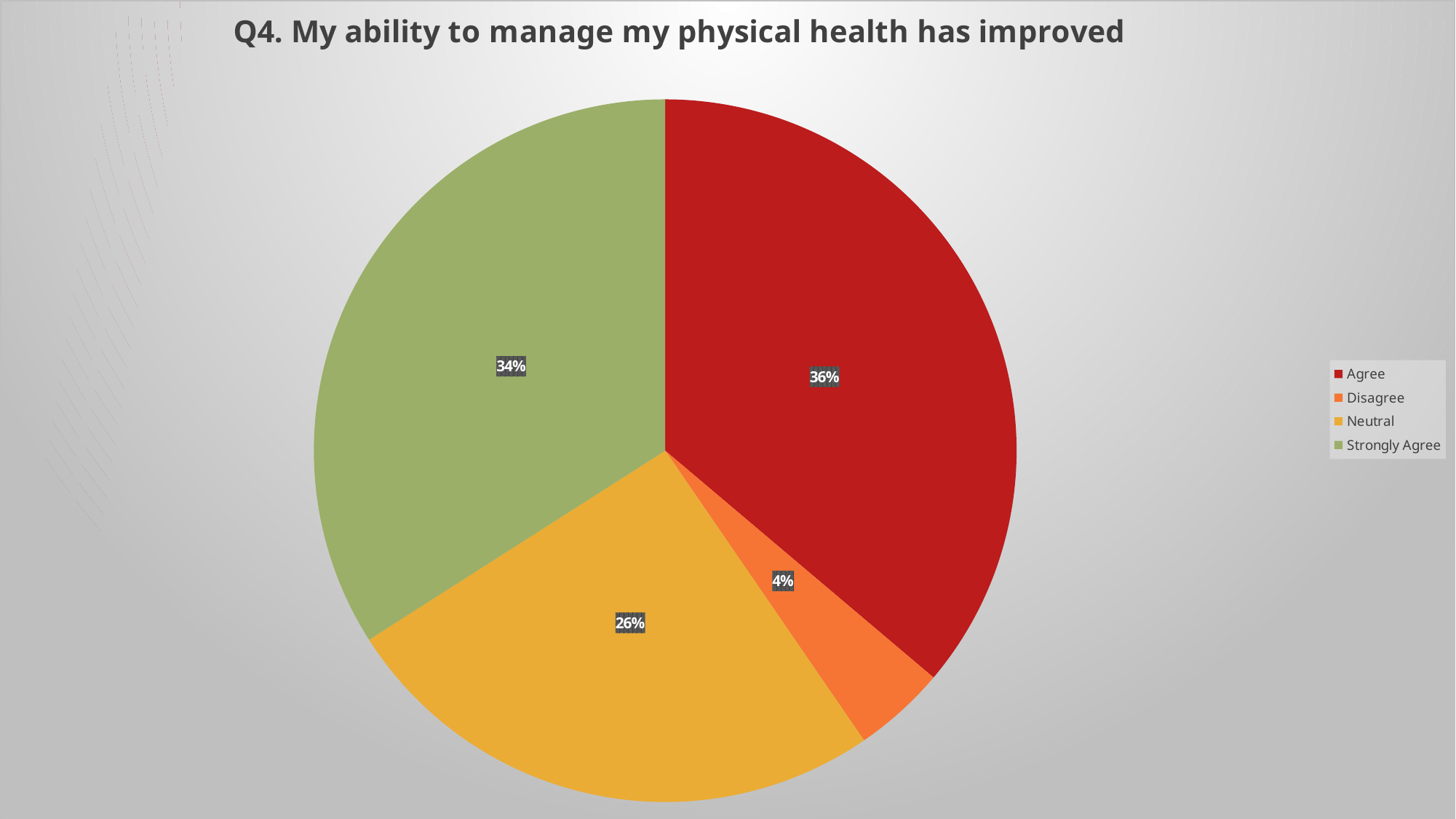
Which is larger, the share for Neutral or the share for Strongly Agree? Strongly Agree What is the title of the chart? Q4. My ability to manage my physical health has improved What percentage of respondents chose Strongly Agree? 34% What percentage of respondents chose Neutral? 26% How many entries does the legend list? 4 How many slices does the pie chart have? 4 What percentage of respondents chose Agree? 36% What is the difference in percentage points between Neutral and Disagree? 22 Which response category has the smallest share of the pie? Disagree What kind of chart is shown on the slide? Pie chart What percentage of respondents chose Disagree? 4% Which response category has the largest share of the pie? Agree